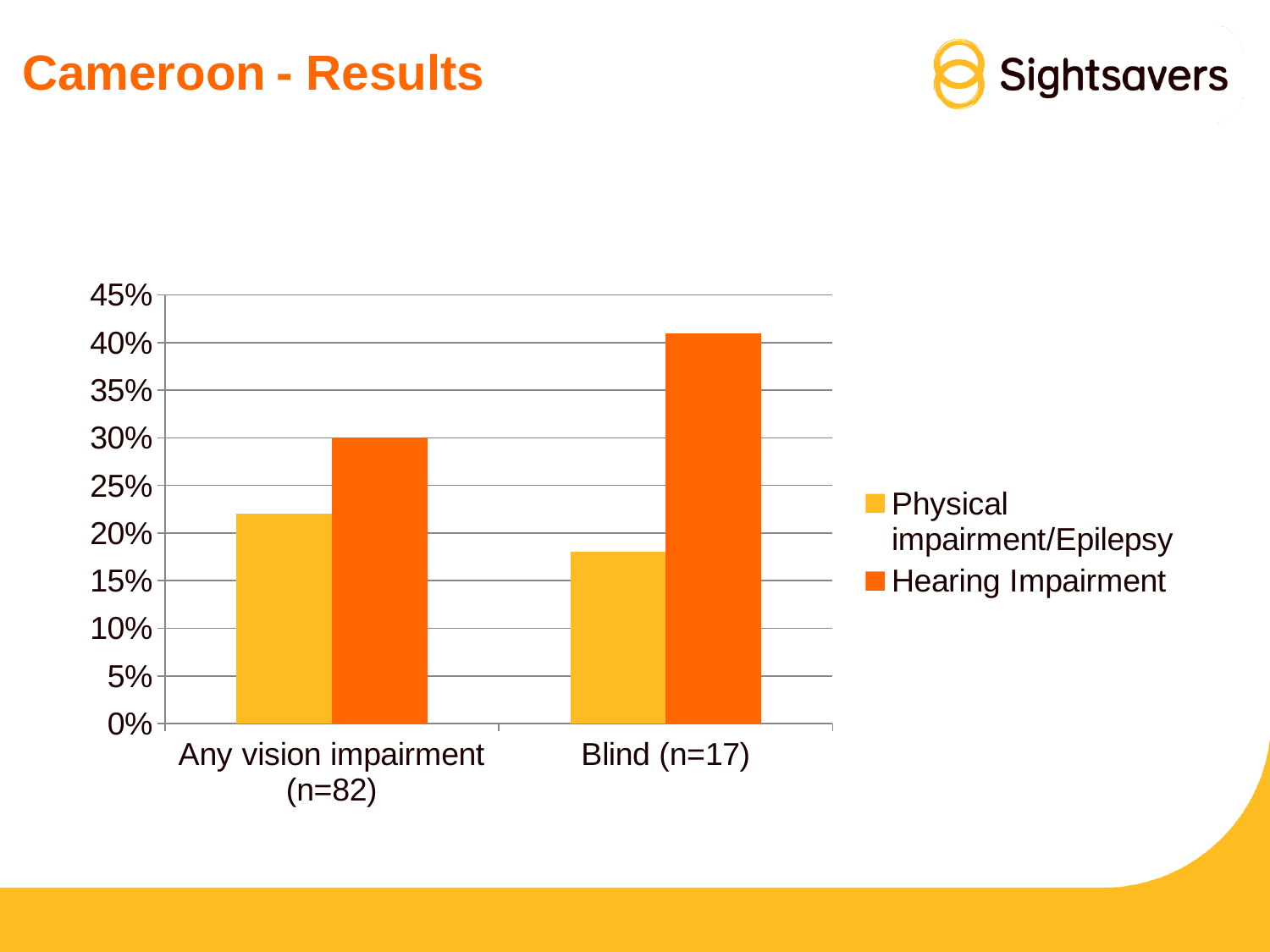
Which bar is the tallest in the chart? Hearing Impairment for Blind (n=17) What kind of chart is shown on the slide? bar chart Is the value for Hearing Impairment in the Any vision impairment (n=82) category greater or less than 25%? greater Is the value for Physical impairment/Epilepsy in the Any vision impairment (n=82) category greater or less than 20%? greater Is the value for Physical impairment/Epilepsy in the Blind (n=17) category greater or less than 20%? less How many series does the chart's legend list? 2 Which series has the higher value in the Blind (n=17) category? Hearing Impairment What is the title of the slide containing the chart? Cameroon - Results Which bar is the shortest in the chart? Physical impairment/Epilepsy for Blind (n=17) Which category has the higher value for Hearing Impairment? Blind (n=17) How many categories are shown on the x axis of the chart? 2